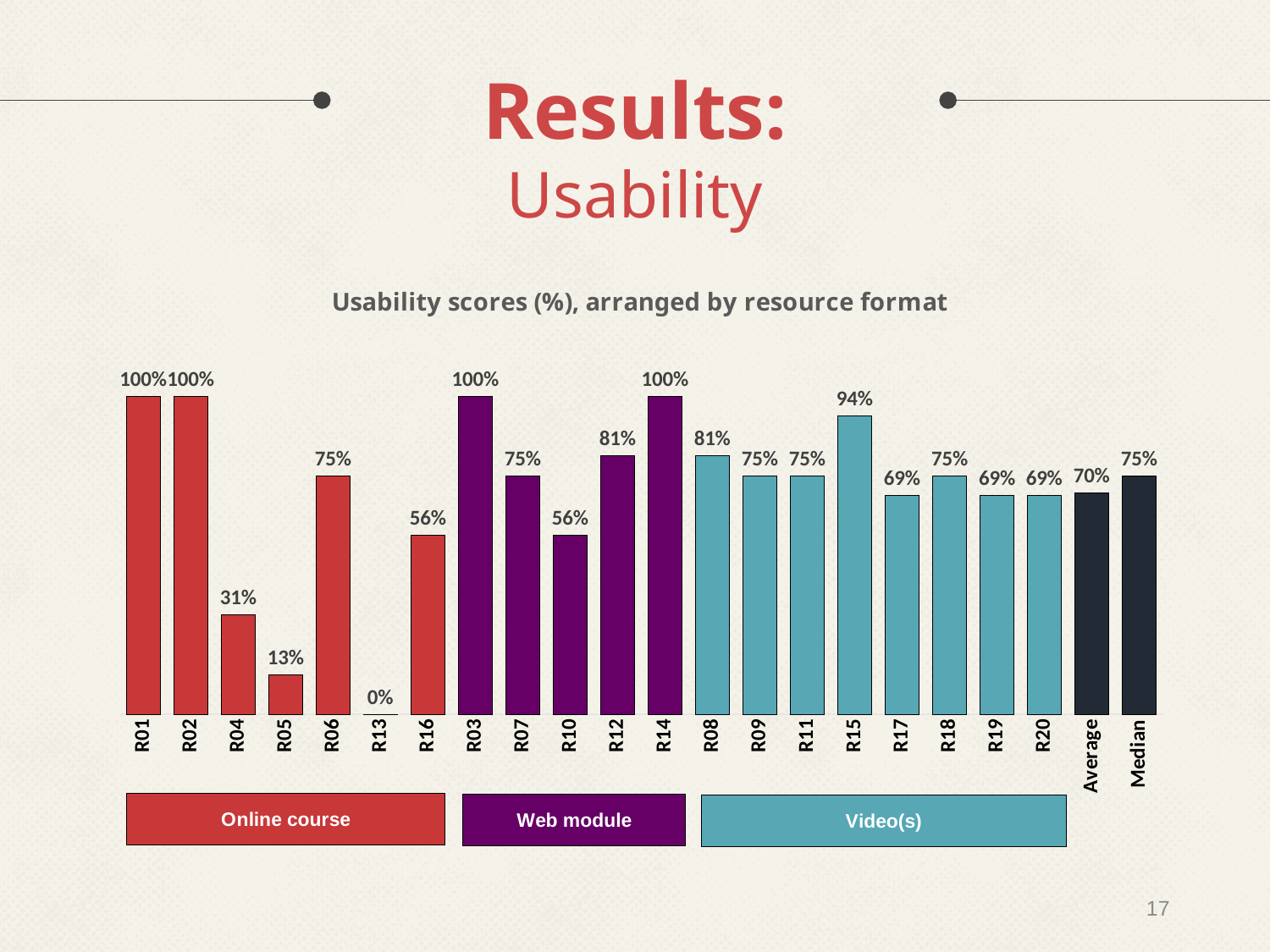
What is the title of the chart? Usability scores (%), arranged by resource format Which has a higher usability score, R04 or R16? R16 What is the Average usability score shown on the chart? 70% What is the difference between the usability scores of R12 and R10? 25% How many resources are in the Video(s) group? 8 What kind of chart is shown on the slide? Bar chart What is the highest usability score shown on the chart? 100% What is the usability score for R05? 13% Among the Video(s) resources, which one has the highest usability score? R15 Which resource has the lowest usability score? R13 What is the Median usability score shown on the chart? 75% What is the usability score for R15? 94%